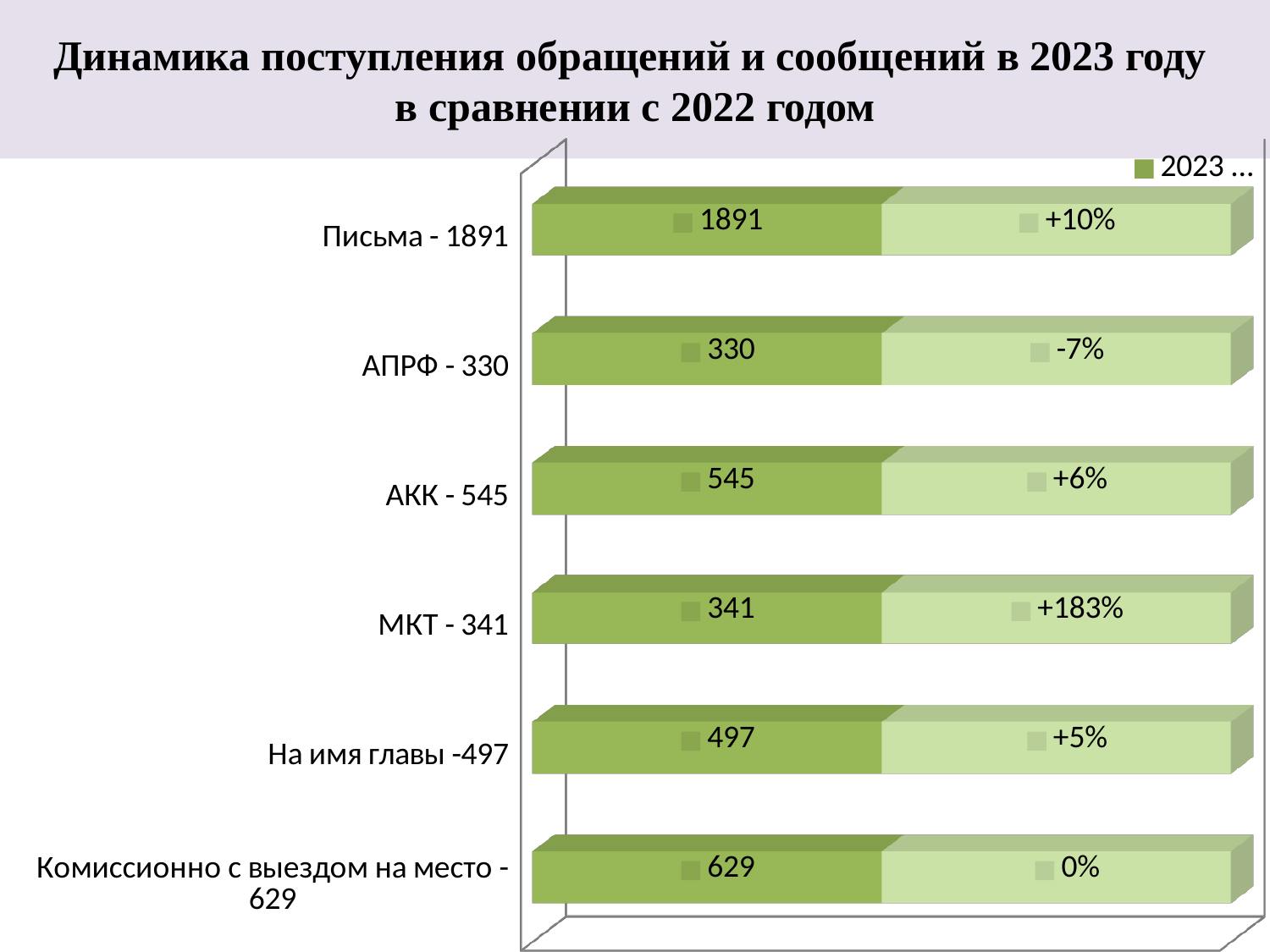
Which has a larger 2023 value, АКК or На имя главы? АКК What is the 2023 value shown for АКК? 545 What percentage change is shown for Комиссионно с выездом на место? 0% Which category has the lowest 2023 value? АПРФ What percentage change is shown for МКТ? +183% How many categories are shown on the chart? 6 What is the difference between the 2023 values for Письма and Комиссионно с выездом на место? 1262 Which category shows the largest percentage change? МКТ What percentage change is shown for АПРФ? -7% What is the 2023 value shown for Письма? 1891 Which category has the highest 2023 value? Письма What kind of chart is shown on the slide? Bar chart